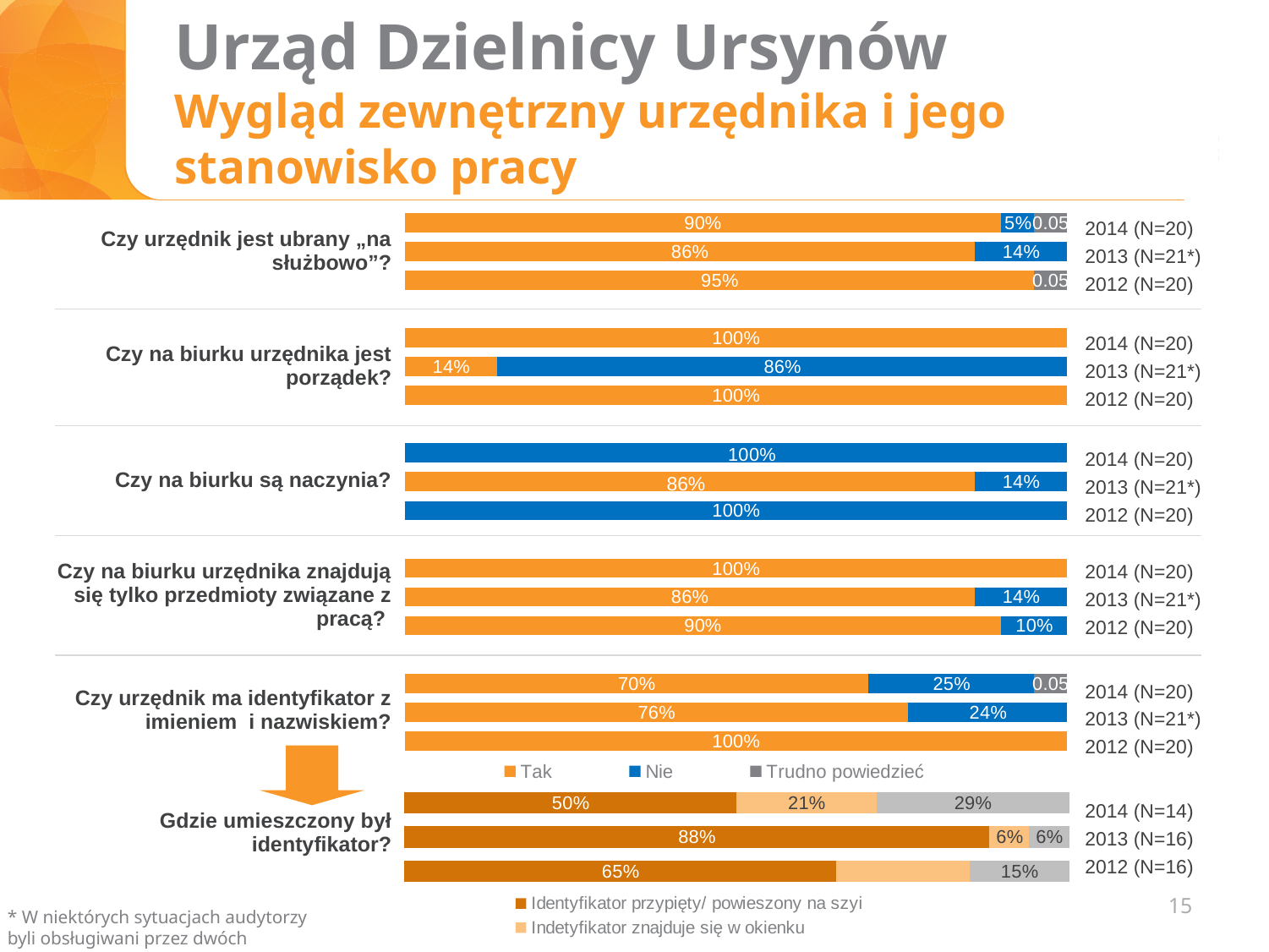
What type of chart is used on this slide? Stacked bar chart In the chart "Czy urzędnik jest ubrany „na służbowo”?", what percentage answered "Tak" in 2014 (N=20)? 90% In the chart "Czy urzędnik ma identyfikator z imieniem i nazwiskiem?", which year has the lowest "Tak" share? 2014 (N=20) In the chart "Czy urzędnik jest ubrany „na służbowo”?", what percentage answered "Nie" in 2013 (N=21*)? 14% In the chart "Czy na biurku urzędnika znajdują się tylko przedmioty związane z pracą?", what is the difference between the "Tak" share in 2014 (N=20) and in 2012 (N=20)? 10% In the chart "Czy urzędnik ma identyfikator z imieniem i nazwiskiem?", what percentage answered "Nie" in 2014 (N=20)? 25% In the chart "Czy urzędnik jest ubrany „na służbowo”?", which year has the highest "Tak" share? 2012 (N=20) How many series does the legend list for the chart "Czy urzędnik ma identyfikator z imieniem i nazwiskiem?"? 3 In the chart "Gdzie umieszczony był identyfikator?", what percentage in 2013 (N=16) had the identifier pinned/hung on the neck ("Identyfikator przypięty/ powieszony na szyi")? 88% In the chart "Czy na biurku urzędnika jest porządek?", what percentage answered "Nie" in 2013 (N=21*)? 86% In the chart "Gdzie umieszczony był identyfikator?", is the "Identyfikator przypięty/ powieszony na szyi" share larger in 2014 (N=14) or in 2012 (N=16)? 2012 (N=16) In the chart "Czy na biurku są naczynia?", what percentage answered "Tak" in 2013 (N=21*)? 86%